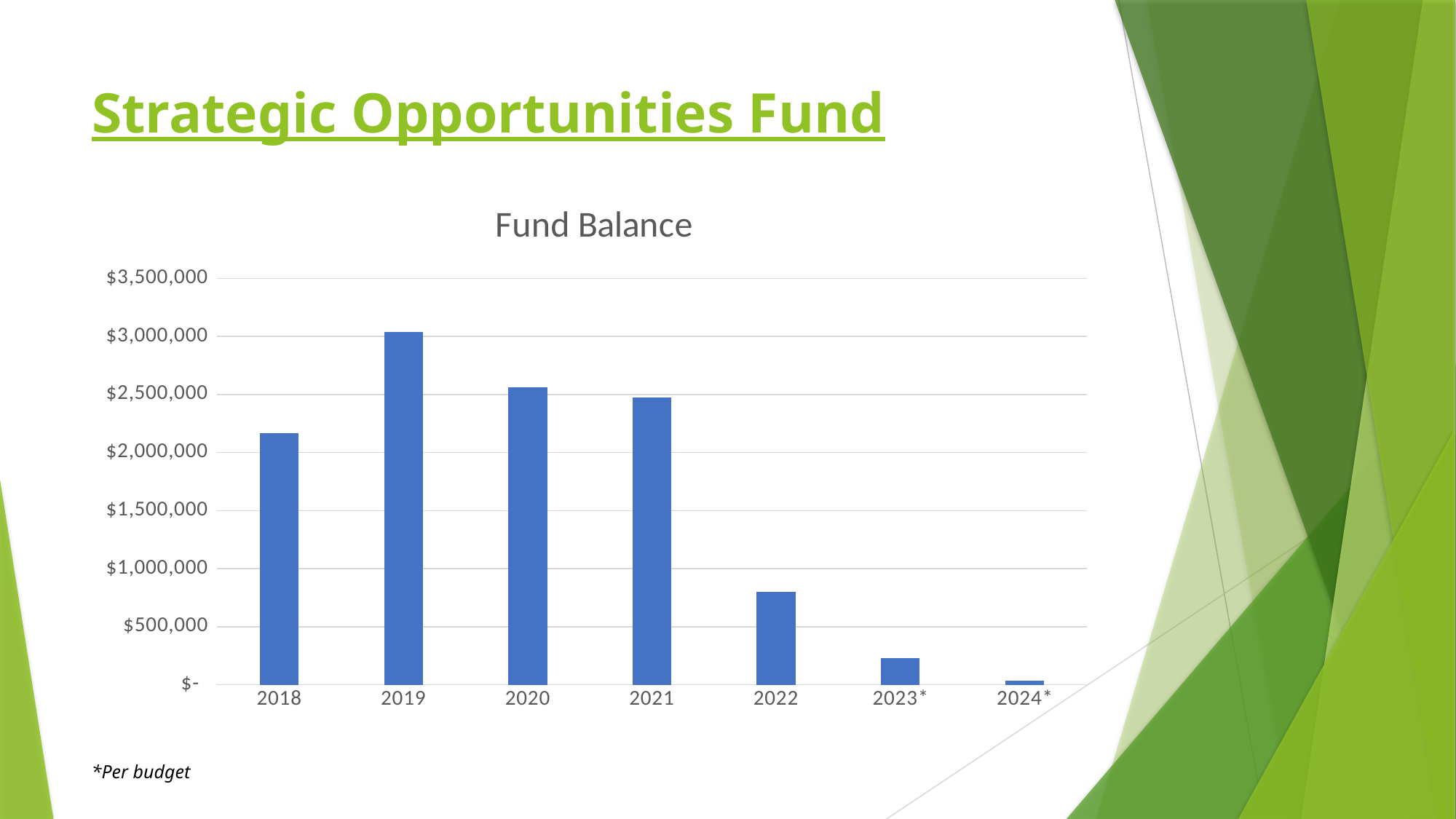
Does the fund balance rise or fall from 2019 to 2024*? fall Is the fund balance for 2022 greater or less than $1,000,000? less How many years are shown on the x axis of the chart? 7 Which year has a larger fund balance, 2020 or 2021? 2020 Which year has the lowest fund balance? 2024* Is the fund balance for 2023* greater or less than $500,000? less Which year has the highest fund balance? 2019 What type of chart is shown on the slide? bar chart Which year has a larger fund balance, 2018 or 2022? 2018 What is the title of the chart? Fund Balance Is the fund balance for 2018 greater or less than $2,000,000? greater